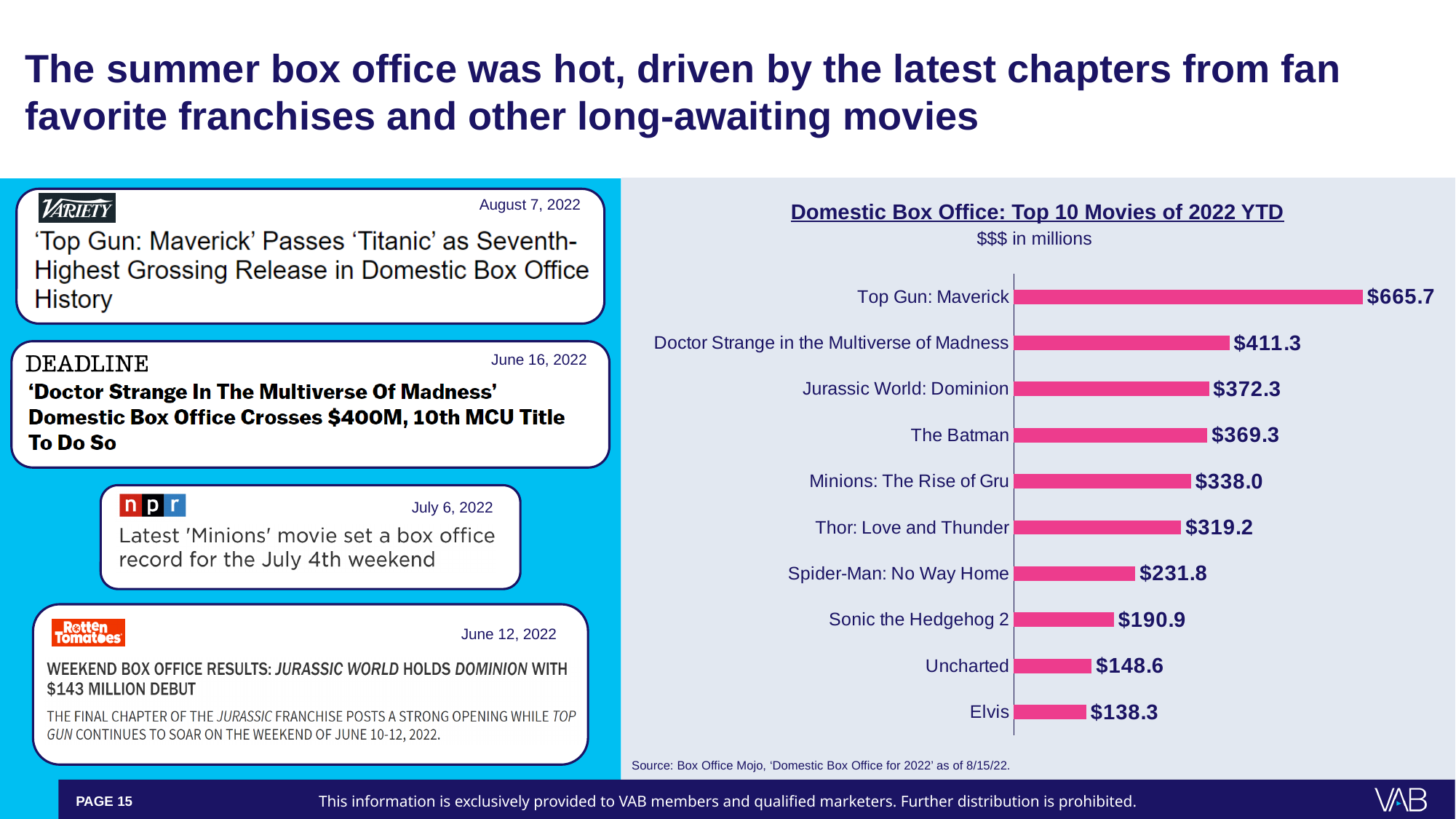
What is the value shown for Uncharted? $148.6 What is the title of the chart? Domestic Box Office: Top 10 Movies of 2022 YTD Which movie has the highest domestic box office in the chart? Top Gun: Maverick Which movie has the lowest domestic box office in the chart? Elvis What is the domestic box office value for Top Gun: Maverick? $665.7 Which has a higher value, Thor: Love and Thunder or Spider-Man: No Way Home? Thor: Love and Thunder In what units are the chart values expressed? $$$ in millions What is the difference between Spider-Man: No Way Home and Sonic the Hedgehog 2? $40.9 How many movies are shown in the chart? 10 What is the value shown for Minions: The Rise of Gru? $338.0 What is the difference between Top Gun: Maverick and Doctor Strange in the Multiverse of Madness? $254.4 What kind of chart is used to show the domestic box office figures? Bar chart